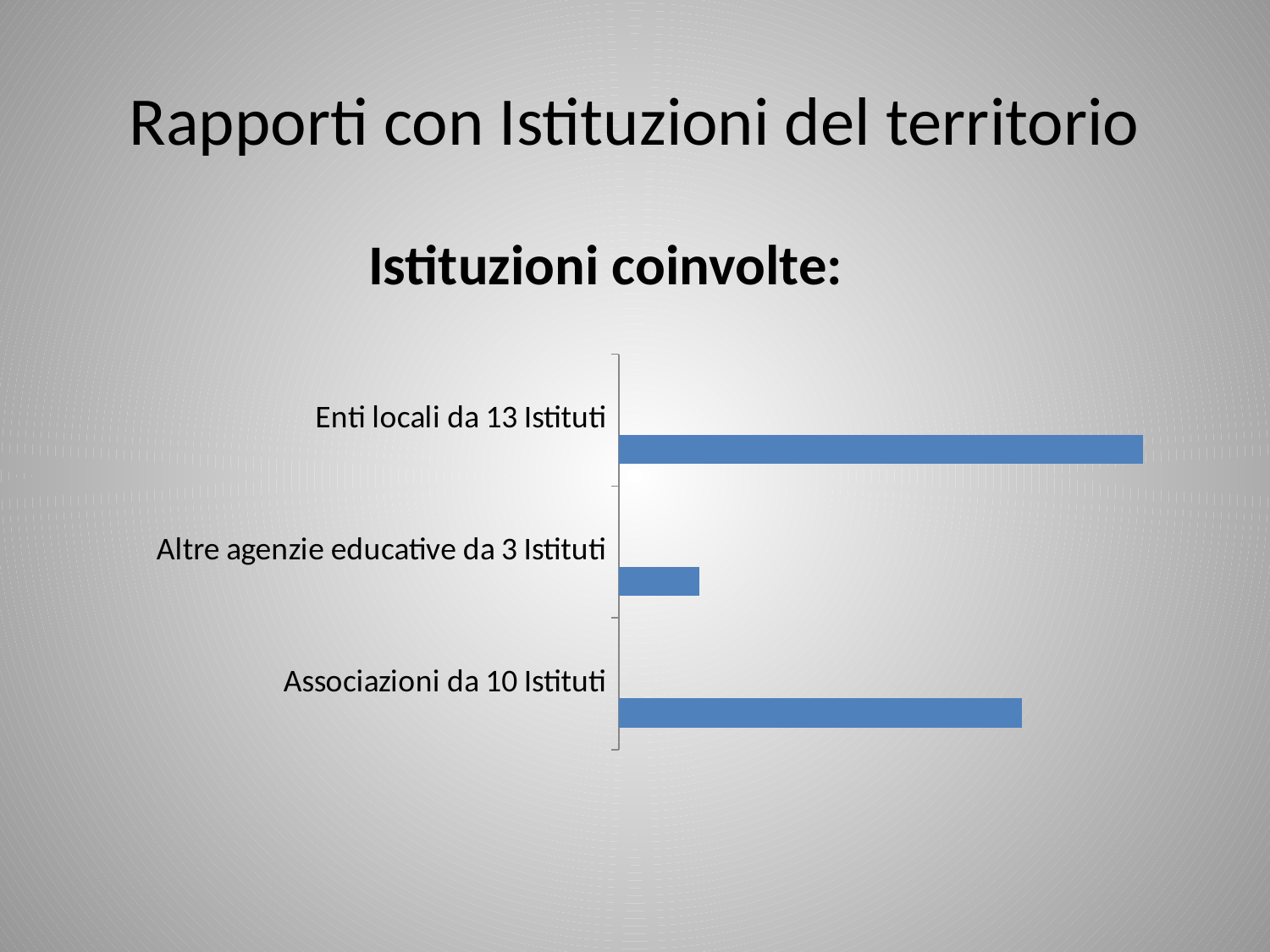
According to its category label, from how many Istituti do the Altre agenzie educative come? 3 Which bar is longer: Altre agenzie educative or Associazioni? Associazioni What is the title shown above the chart? Istituzioni coinvolte: What kind of chart is shown on the slide? bar chart According to its category label, from how many Istituti do the Associazioni come? 10 According to its category label, from how many Istituti do the Enti locali come? 13 What colour are the bars in the chart? blue Using the numbers in the category labels, how many more Istituti are there for Enti locali than for Associazioni? 3 How many categories does the chart show? 3 Which bar is longer: Enti locali or Associazioni? Enti locali Which category has the longest bar in the chart? Enti locali da 13 Istituti Which category has the shortest bar in the chart? Altre agenzie educative da 3 Istituti